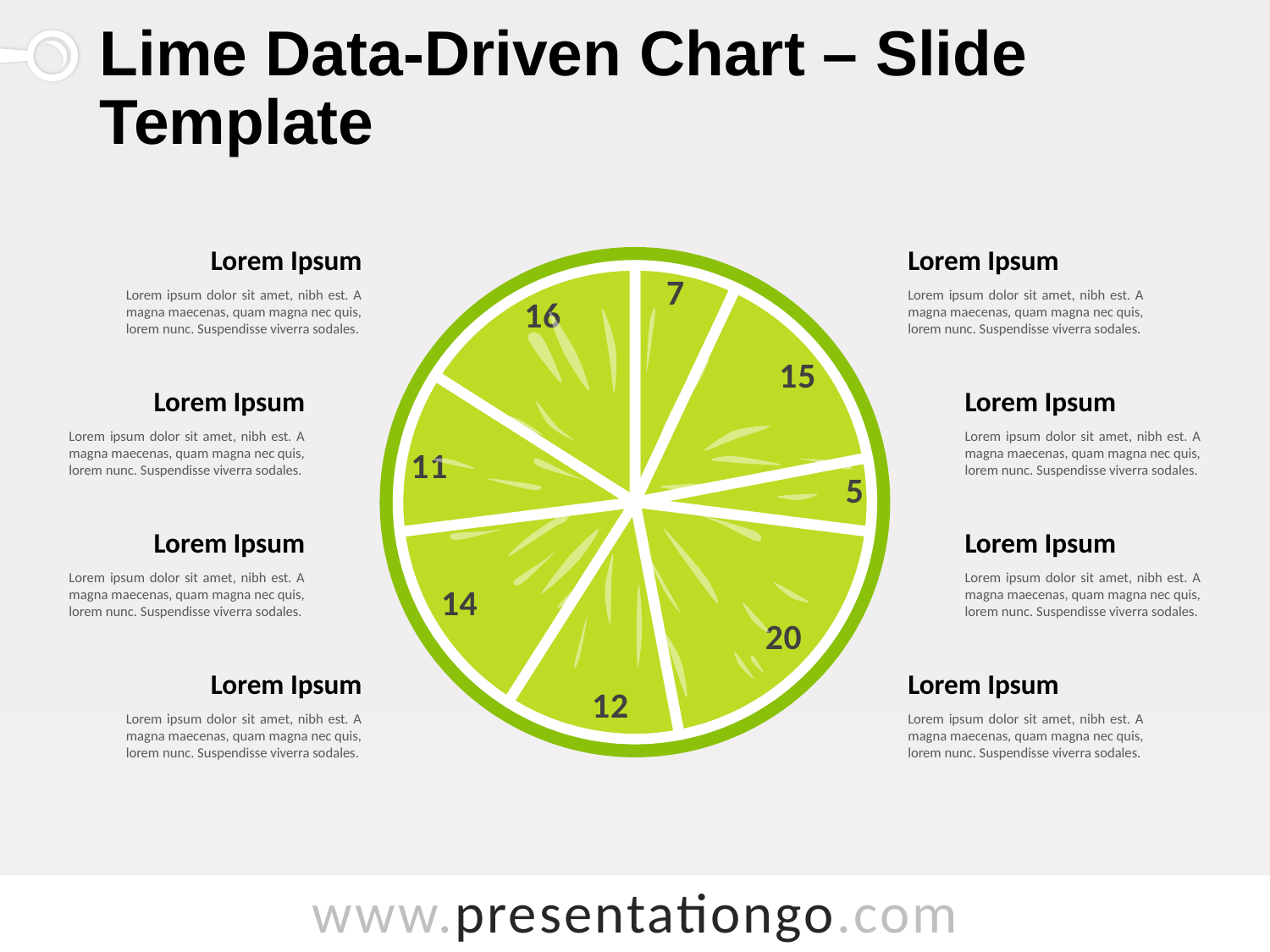
What is the difference between the largest and smallest slice values on the pie chart? 15 What kind of chart is shown on the slide? pie chart What is the smallest value labelled on the pie chart? 5 How many slices does the pie chart have? 8 Which is larger on the pie chart, the slice labelled 16 or the slice labelled 15? 16 What is the difference between the slice labelled 14 and the slice labelled 11 on the pie chart? 3 What is the largest value labelled on the pie chart? 20 What share of the pie does the slice labelled 5 represent? 5% What colour are the slices of the pie chart? green What is the title of the slide containing the pie chart? Lime Data-Driven Chart – Slide Template What share of the pie does the slice labelled 20 represent? 20% What is the sum of all the slice values shown on the pie chart? 100